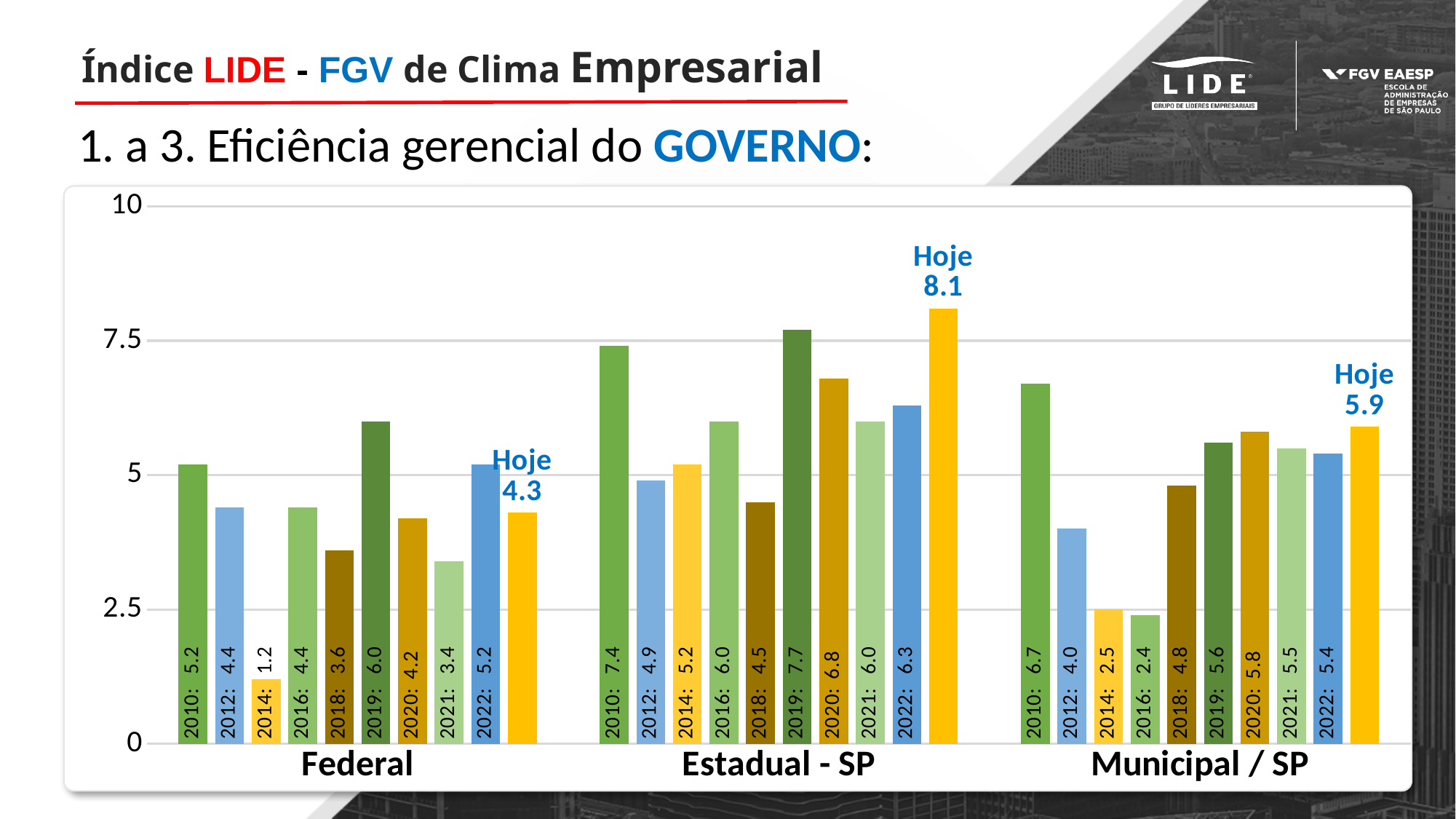
What kind of chart is shown on the slide? bar chart Which year has the highest value in the Estadual - SP group, excluding 'Hoje'? 2019 Which year has the lowest value in the Municipal / SP group? 2016 How many groups of bars are shown on the x axis? 3 What is the difference between the 2019 and 2021 values in the Federal group? 2.6 Is the 2018 value for Estadual - SP greater or less than 5? less What is the 'Hoje' value for Estadual - SP? 8.1 What is the value for 2019 in the Municipal / SP group? 5.6 What is the value for 2014 in the Federal group? 1.2 What is the difference between the 'Hoje' value for Estadual - SP and the 'Hoje' value for Federal? 3.8 Which is larger: the 2010 value for Federal or the 2010 value for Municipal / SP? Municipal / SP How many bars are in the Federal group? 10